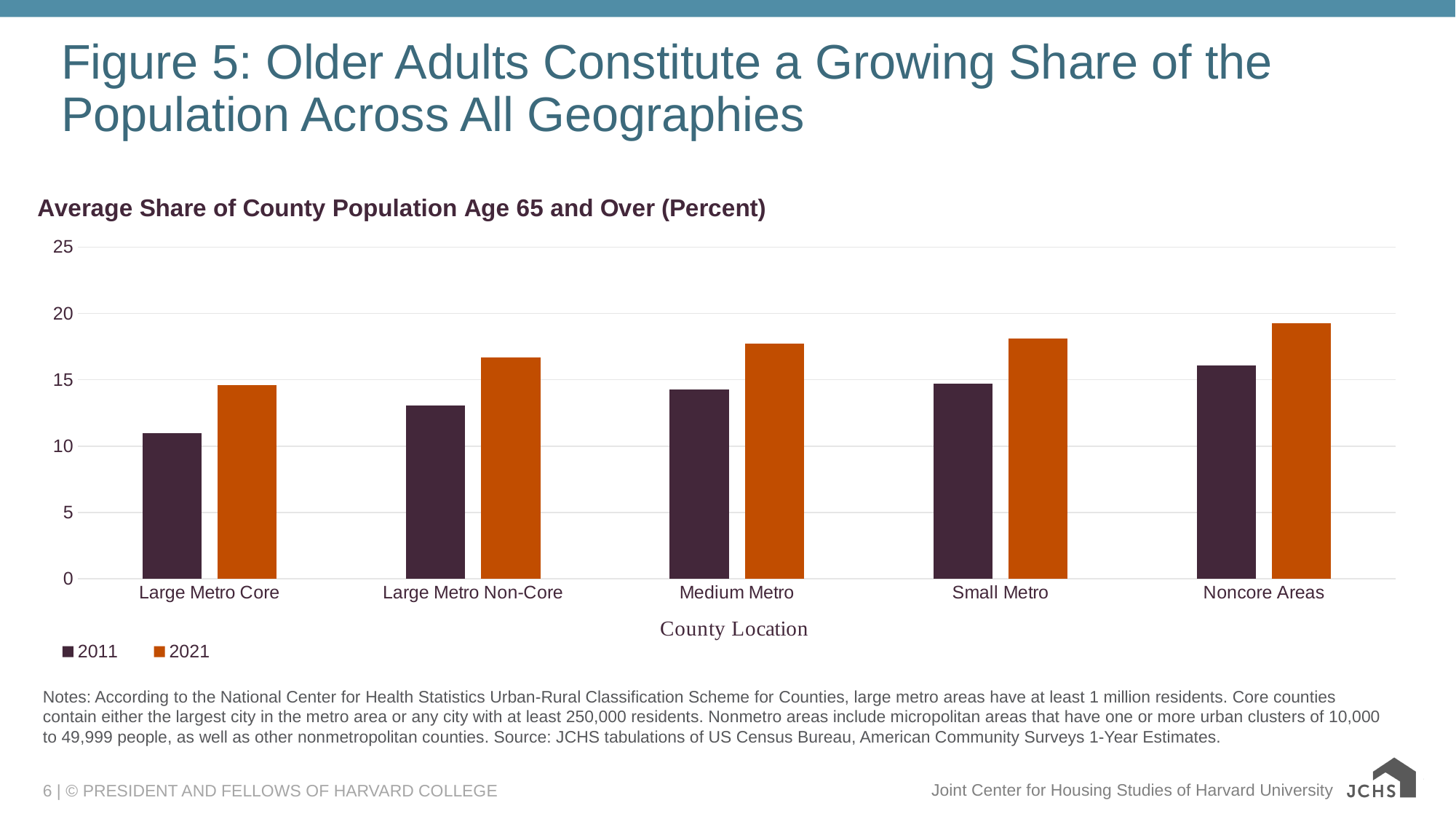
Which county location has the lowest 2011 value? Large Metro Core Is the 2011 value for Large Metro Non-Core greater or less than 15? less Which county location has the highest 2021 value? Noncore Areas Is the 2011 value for Large Metro Core greater or less than 15? less What kind of chart is shown on the slide? bar chart Which is larger: the 2011 value for Noncore Areas or the 2021 value for Large Metro Core? 2011 value for Noncore Areas Do the 2021 values rise or fall moving from Large Metro Core to Noncore Areas along the x axis? rise Which county location has the lowest 2021 value? Large Metro Core How many series does the legend list? 2 What is the label of the x axis? County Location How many county location categories are shown on the x axis? 5 Is the 2021 value for Medium Metro greater or less than 15? greater